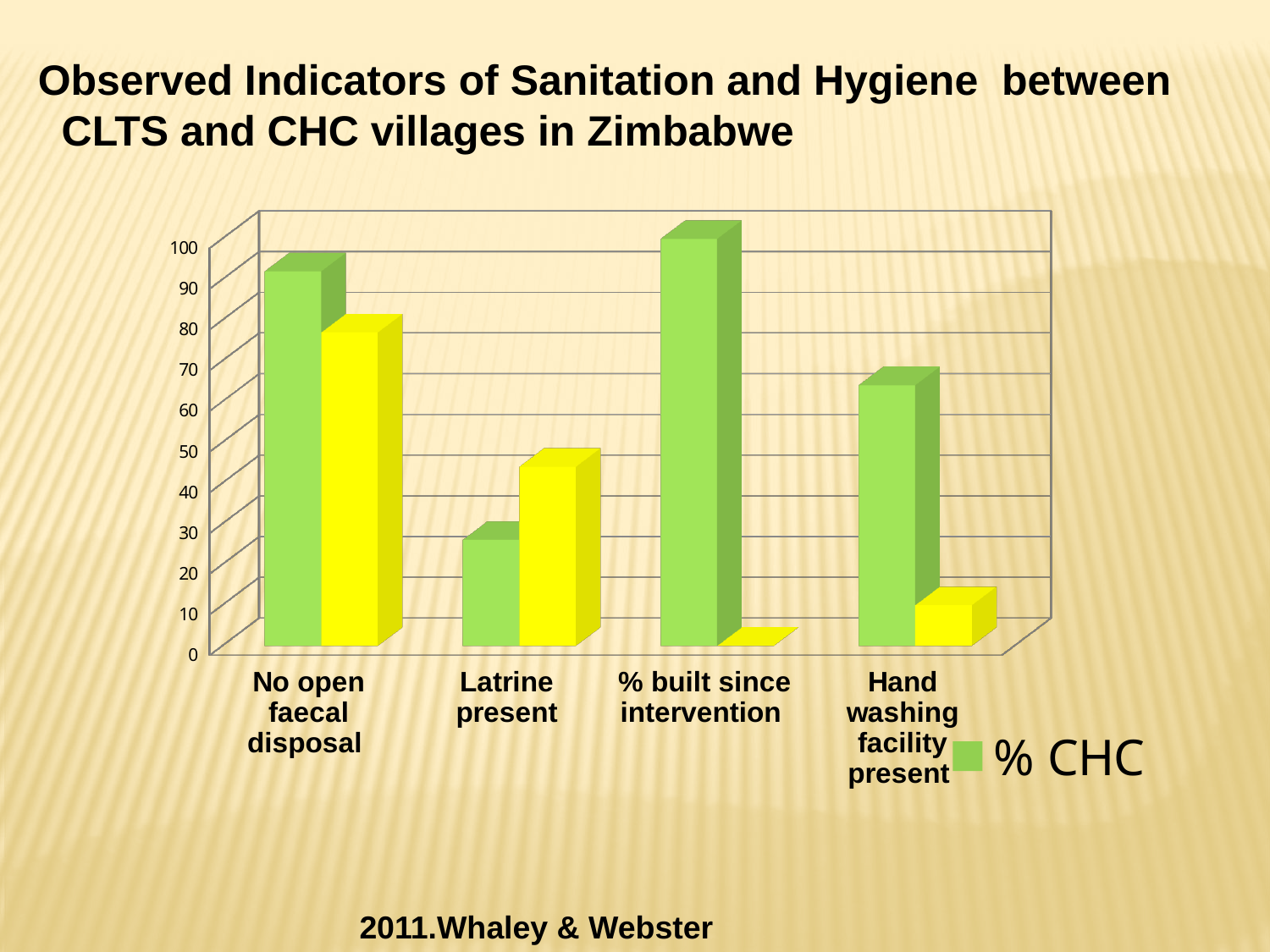
Is the % CHC (green) value for No open faecal disposal greater or less than 80? greater Which category has the lowest % CHC (green) bar? Latrine present How many categories are shown on the x axis of the chart? 4 Is the % CHC (green) value for Latrine present greater or less than 40? less For Latrine present, which bar is taller, the green % CHC bar or the yellow bar? the yellow bar How many series does the chart's legend list? 1 Is the yellow bar for Hand washing facility present greater or less than 20? less What colour are the bars for the % CHC series? green Which category has the highest % CHC (green) bar? % built since intervention What is the series name shown in the chart's legend? % CHC What kind of chart is shown on the slide? bar chart